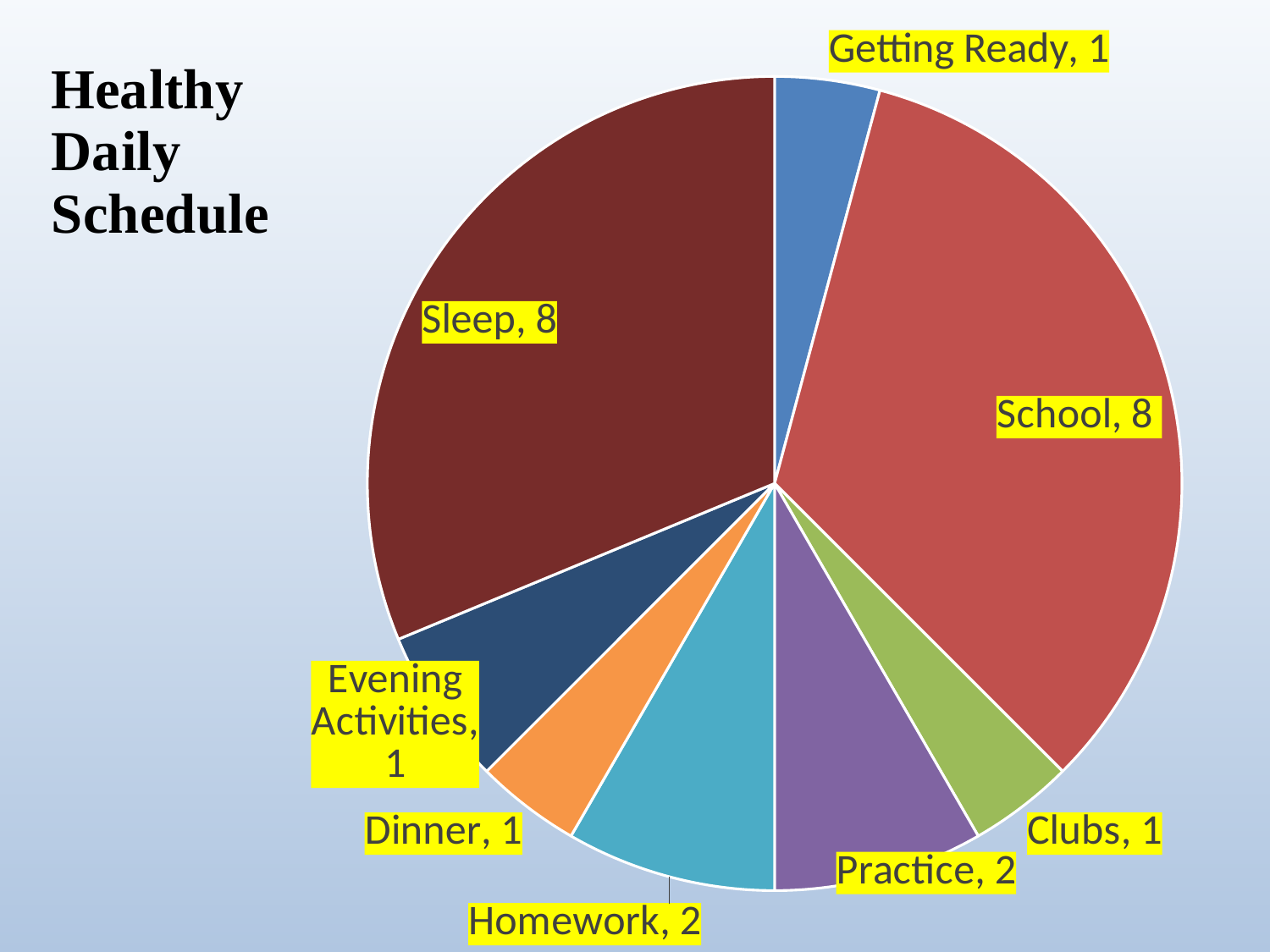
Which is larger in the pie chart, Practice or Dinner? Practice What is the value for Homework in the pie chart? 2 What is the difference between the values for Homework and Getting Ready? 1 What is the value for Evening Activities in the pie chart? 1 What kind of chart is shown on the slide? pie chart How many hours are allocated to School in the pie chart? 8 What is the title of the chart on the slide? Healthy Daily Schedule How many categories (slices) does the pie chart have? 8 What is the difference between the values for School and Clubs? 7 Which is larger in the pie chart, Sleep or Homework? Sleep What is the value for Practice in the pie chart? 2